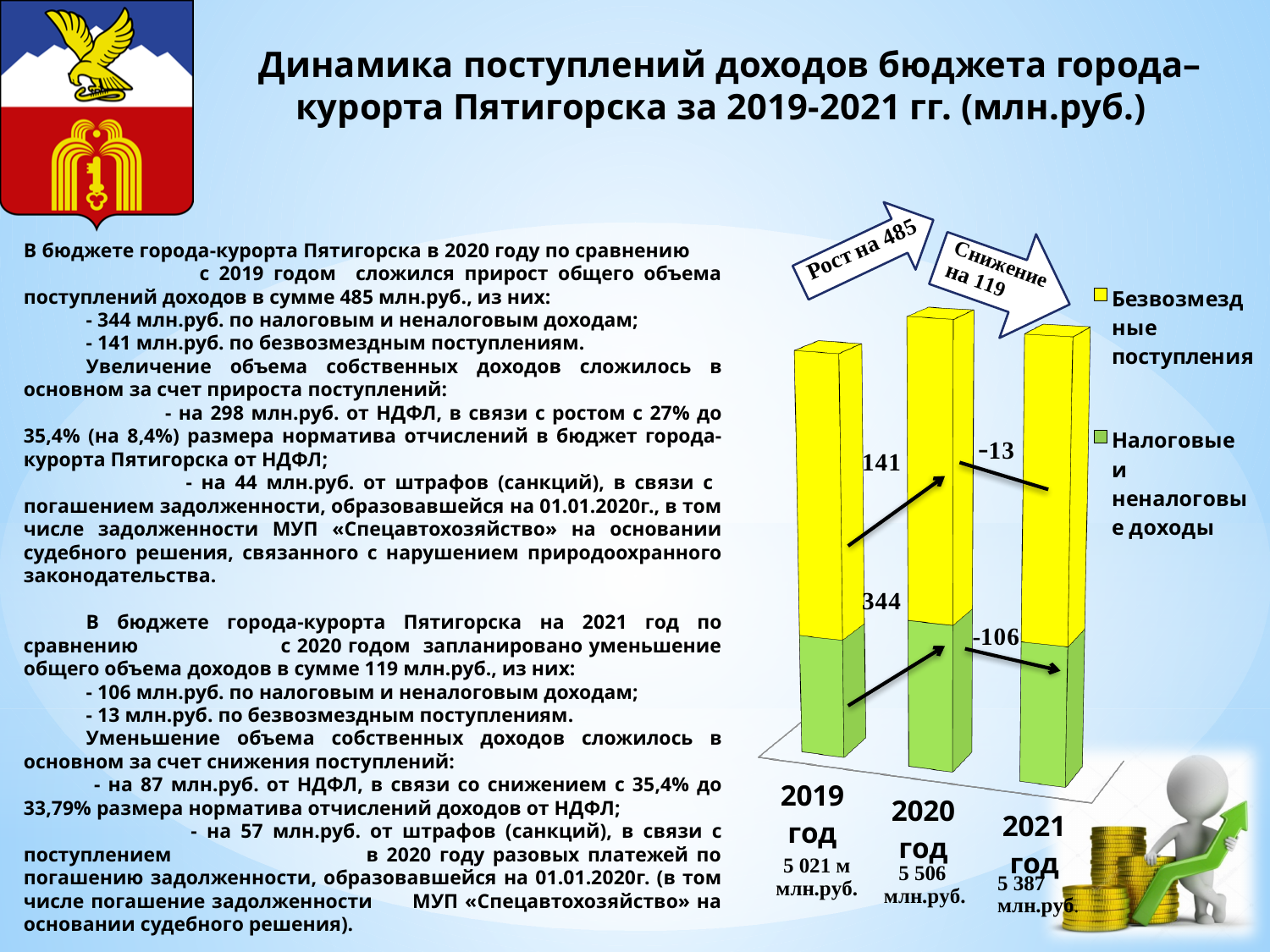
What is the total budget revenue shown for 2021? 5 387 млн.руб. Which year has the lowest total revenue on the chart? 2019 год What kind of chart is shown on the slide? Stacked bar chart By how much is the total revenue for 2021 lower than the total for 2020? 119 млн.руб. Which is larger, the total revenue for 2021 or for 2019? 2021 год What change in 'Безвозмездные поступления' from 2019 to 2020 is annotated on the chart? 141 By how much does the total revenue for 2020 exceed the total for 2019? 485 млн.руб. Which colour represents 'Налоговые и неналоговые доходы' in the chart? Green What is the total budget revenue shown for 2020? 5 506 млн.руб. Which year has the highest total revenue on the chart? 2020 год How many series does the chart legend list? 2 How many years (bars) are shown on the chart? 3